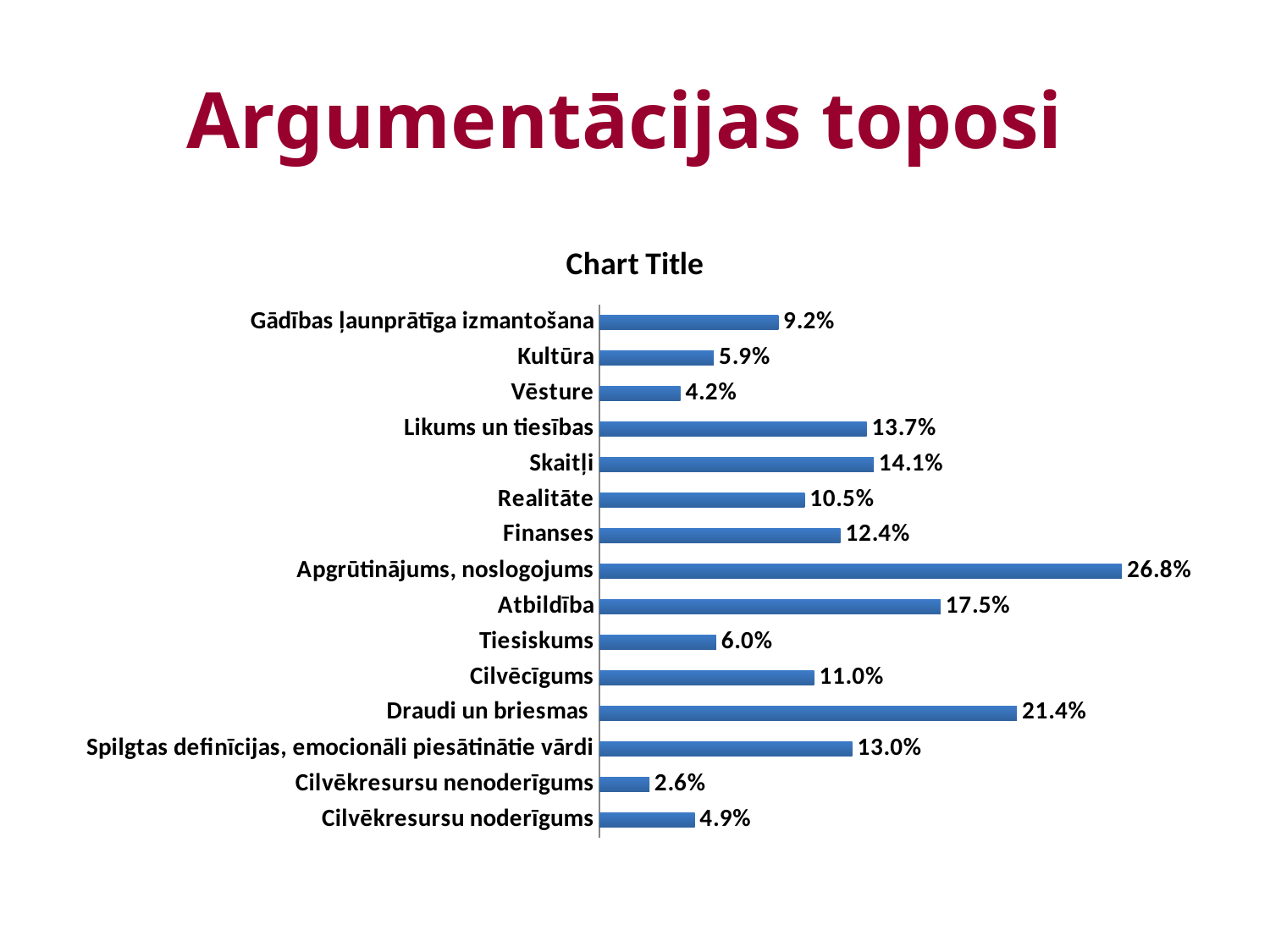
What is the value for Skaitļi? 14.1% What is the difference between the values for Kultūra and Vēsture? 1.7% What is the title shown above the chart? Chart Title Which category has the highest value? Apgrūtinājums, noslogojums What is the value for Cilvēkresursu nenoderīgums? 2.6% What kind of chart is shown on the slide? Bar chart What is the value for Spilgtas definīcijas, emocionāli piesātinātie vārdi? 13.0% What is the value for Apgrūtinājums, noslogojums? 26.8% How many categories are shown in the chart? 15 Which category has the lowest value? Cilvēkresursu nenoderīgums Which is larger, the value for Likums un tiesības or the value for Finanses? Likums un tiesības What is the difference between the values for Draudi un briesmas and Atbildība? 3.9%